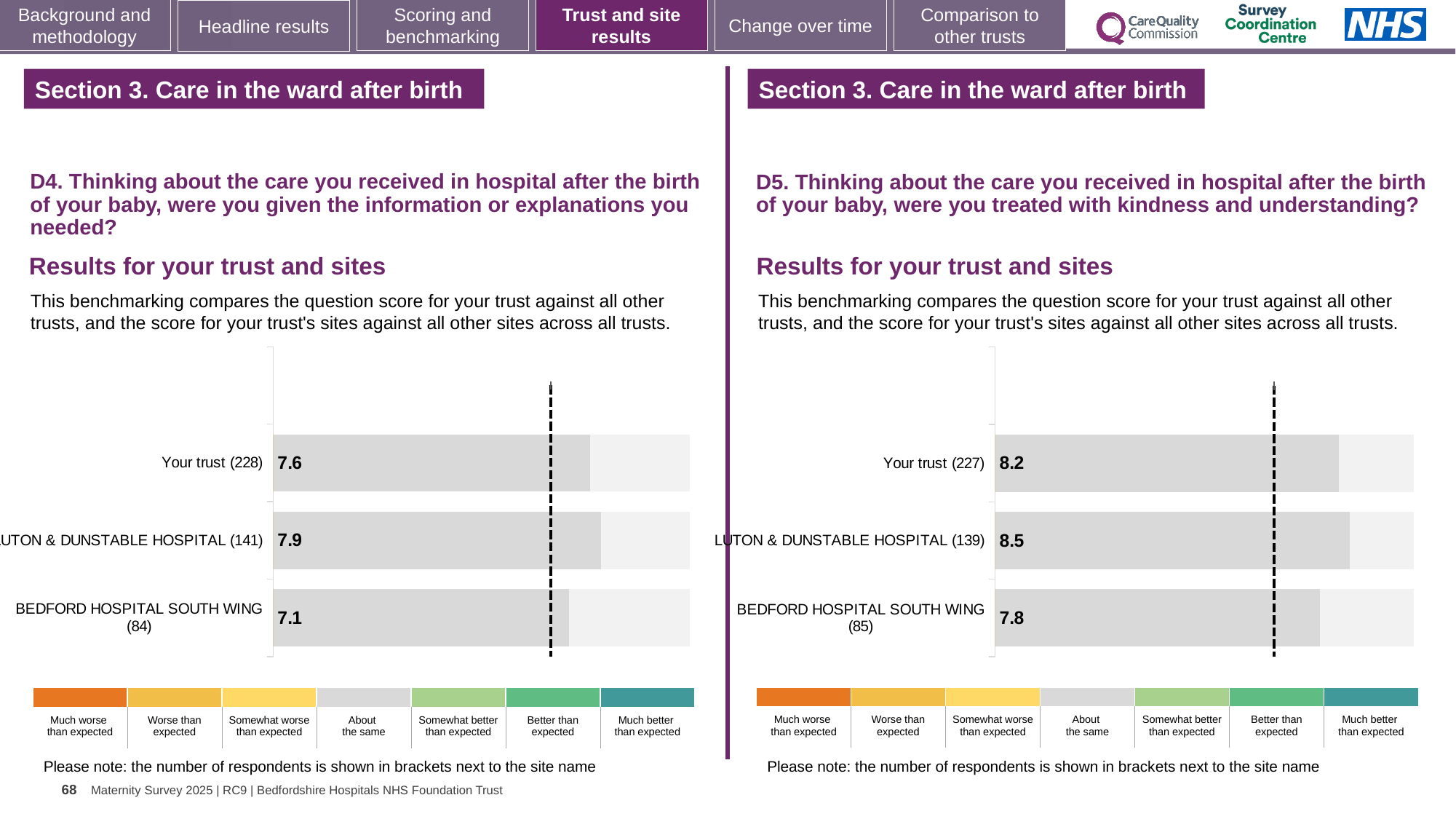
In the D5 chart on the right, what is the score for Luton & Dunstable Hospital (139)? 8.5 In the D4 chart on the left, what is the score for Your trust (228)? 7.6 What type of chart is used in the D5 chart on the right? Bar chart How many bars are plotted in the D4 chart on the left? 3 In the D4 chart on the left, how many respondents are shown in brackets for Your trust? 228 In the D4 chart on the left, which site or trust has the highest score? Luton & Dunstable Hospital (141) In the D5 chart on the right, what is the score for Your trust (227)? 8.2 In the D5 chart on the right, which site or trust has the lowest score? Bedford Hospital South Wing (85) In the D4 chart on the left, what is the score for Bedford Hospital South Wing (84)? 7.1 In the D5 chart on the right, what is the difference between the scores for Your trust and Bedford Hospital South Wing? 0.4 In the D4 chart on the left, what is the difference between the scores for Luton & Dunstable Hospital and Bedford Hospital South Wing? 0.8 In the D5 chart on the right, which has the larger score: Your trust (227) or Luton & Dunstable Hospital (139)? Luton & Dunstable Hospital (139)